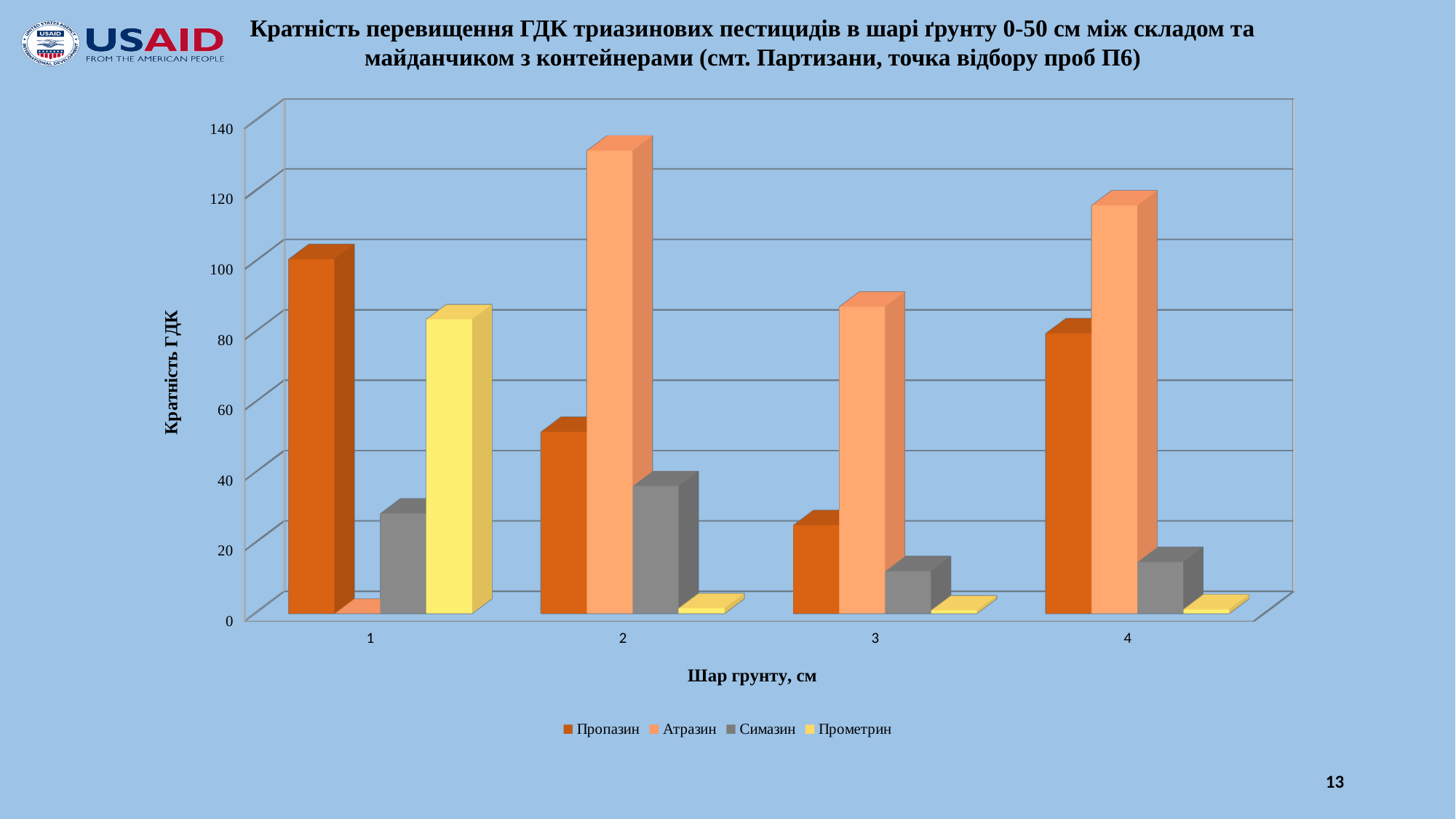
Which is larger: Пропазин in category 1 or Пропазин in category 4? Пропазин in category 1 Is the value for Атразин in category 2 greater or less than 120? greater Is the value for Атразин in category 1 greater or less than 20? less In category 1, which series has the highest value? Пропазин In category 2, which series has the lowest value? Прометрин What is the title of the vertical axis? Кратність ГДК Does the value for Пропазин rise or fall from category 1 to category 3? fall Which series has the tallest bar in the whole chart? Атразин Is the value for Пропазин in category 1 greater or less than 80? greater How many categories are shown on the x axis? 4 How many series does the legend list? 4 What kind of chart is shown on the slide? bar chart